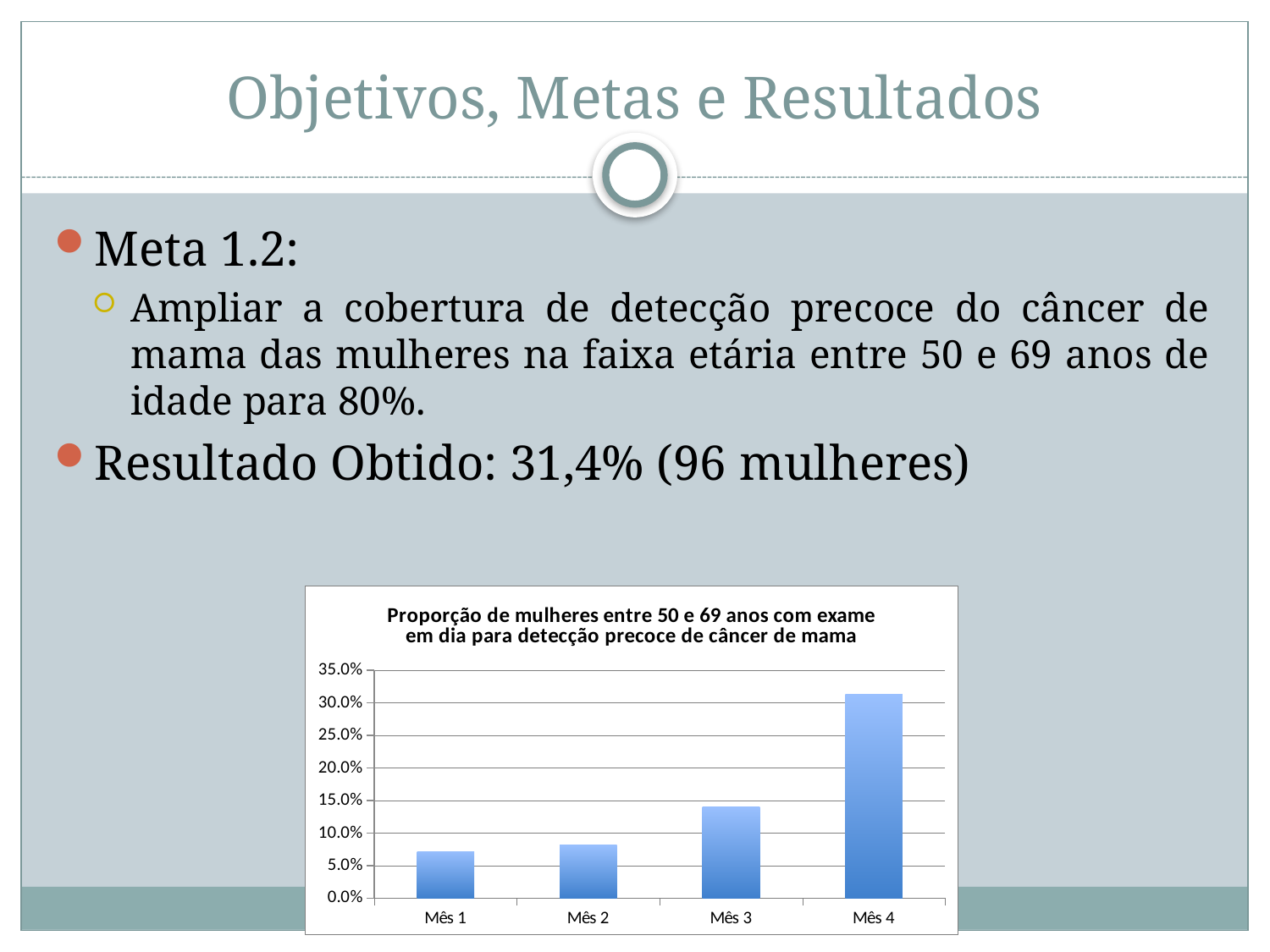
Which month has the highest proportion on the chart? Mês 4 What is the title of the chart? Proporção de mulheres entre 50 e 69 anos com exame em dia para detecção precoce de câncer de mama Is the value for Mês 1 greater or less than 10.0%? less Which is larger, the value for Mês 3 or the value for Mês 4? Mês 4 Do the values rise or fall from Mês 1 to Mês 4? rise What kind of chart is shown on the slide? bar chart Is the value for Mês 4 greater or less than 30.0%? greater Is the value for Mês 3 greater or less than 15.0%? less How many months (categories) are plotted on the chart? 4 Which is larger, the value for Mês 1 or the value for Mês 3? Mês 3